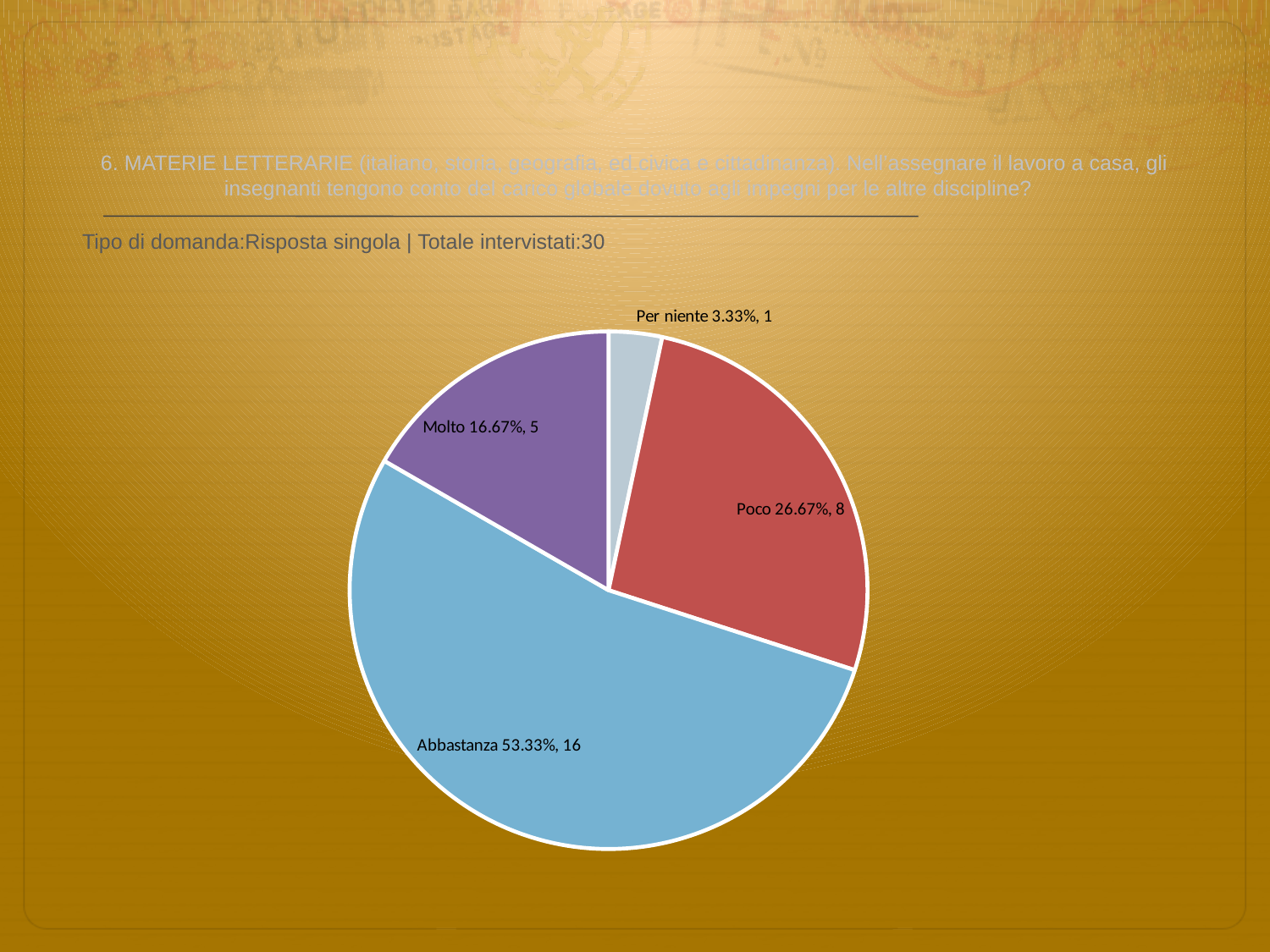
Which category has the largest slice of the pie? Abbastanza Which category has the smallest slice of the pie? Per niente How many respondents answered Poco? 8 What kind of chart is shown on the slide? pie chart Which has more respondents, Molto or Poco? Poco How many respondents answered Per niente? 1 What share of the pie does the Poco slice represent? 26.67% What colour is the Abbastanza slice? light blue What percentage is shown for the Molto slice? 16.67% How many slices does the pie chart have? 4 What percentage is shown for the Abbastanza slice? 53.33% What is the difference in respondent count between Abbastanza and Poco? 8